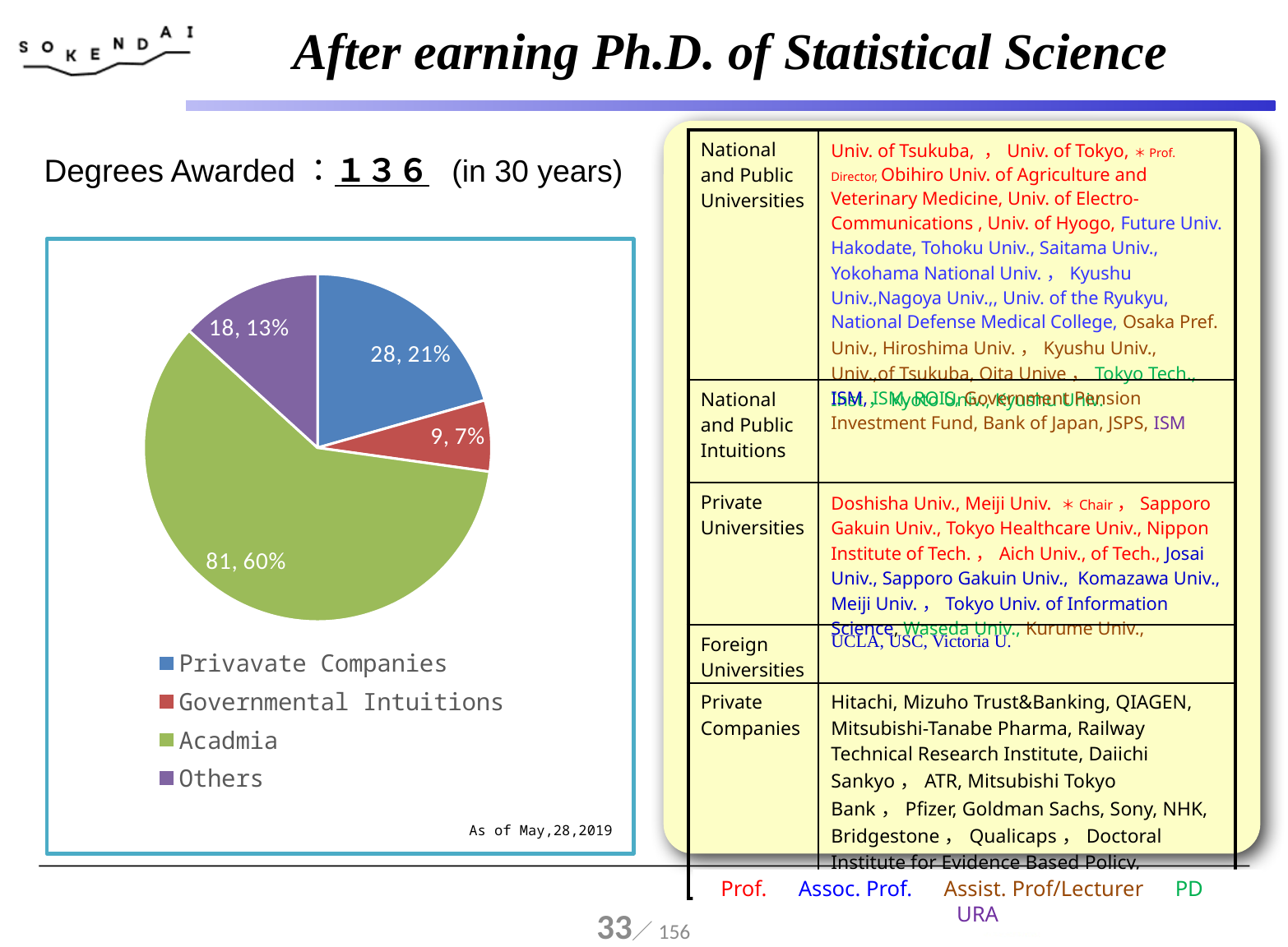
How many slices does the pie chart have? 4 Which is larger, the count for Others or the count for Governmental Intuitions? Others What is the count shown for the Acadmia slice of the pie chart? 81 What kind of chart is shown on the slide? pie chart What is the difference between the counts for Acadmia and Privavate Companies? 53 Which category has the smallest slice in the pie chart? Governmental Intuitions What percentage of the pie does the Privavate Companies slice represent? 21% Which category has the largest slice in the pie chart? Acadmia What is the total of the four counts shown on the pie chart? 136 What percentage share is shown for the Others slice? 13% What is the count shown for the Governmental Intuitions slice? 9 What colour is the Acadmia slice in the pie chart? green